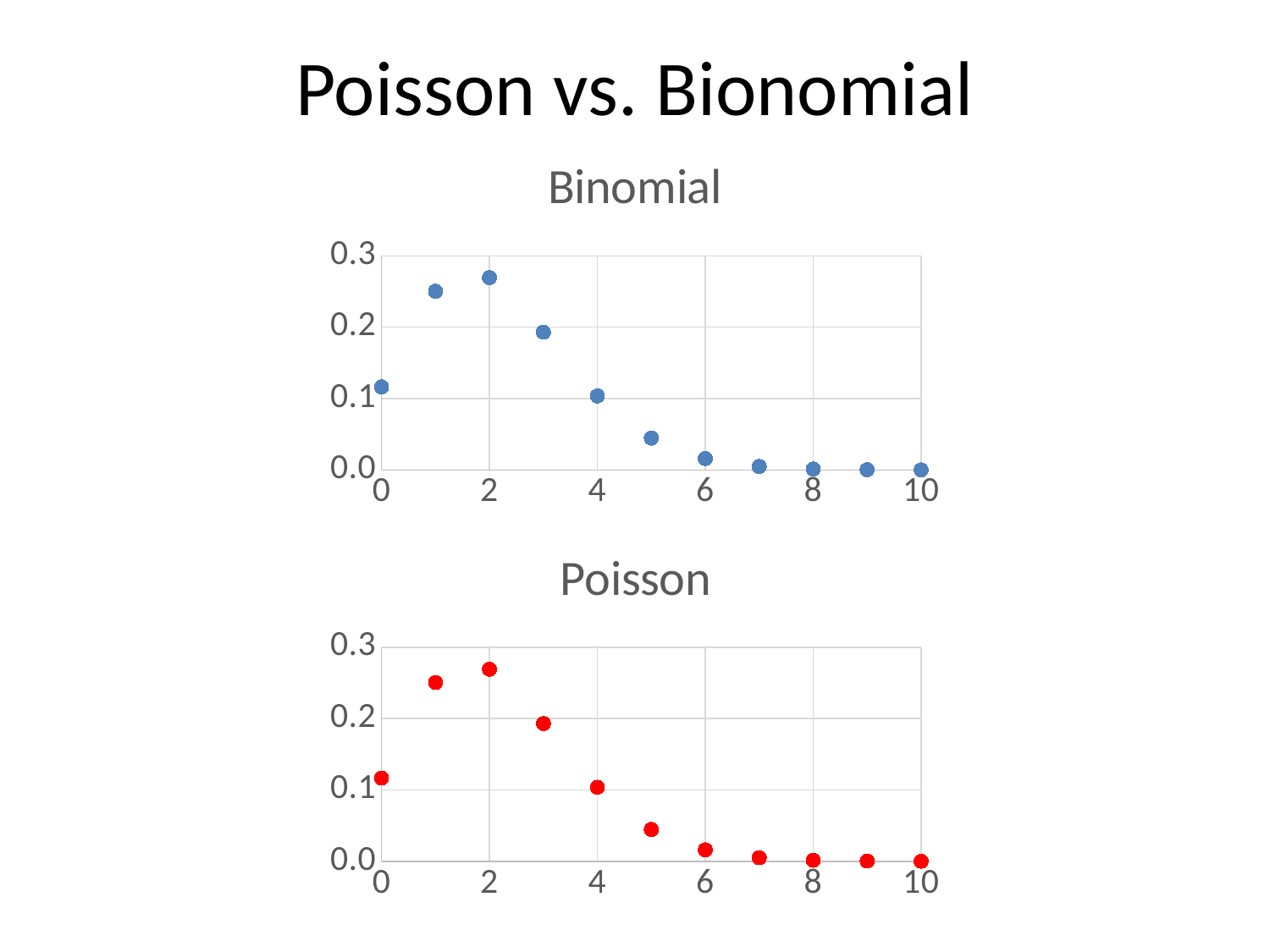
In the Binomial chart, is the value at x = 5 greater or less than 0.1? less In the Poisson chart, at which x value is the plotted value highest? 2 In the Poisson chart, is the value at x = 1 greater or less than 0.2? greater What is the title of the top chart on the slide? Binomial In the Binomial chart, is the value at x = 0 greater or less than 0.1? greater In the Poisson chart, do the values rise or fall from x = 2 to x = 10? fall What type of chart is the Binomial chart? scatter chart What colour are the markers in the Poisson chart? red In the Binomial chart, which has the larger value, x = 2 or x = 4? x = 2 How many data points are plotted in the Poisson chart? 11 In the Binomial chart, at which x value is the plotted value highest? 2